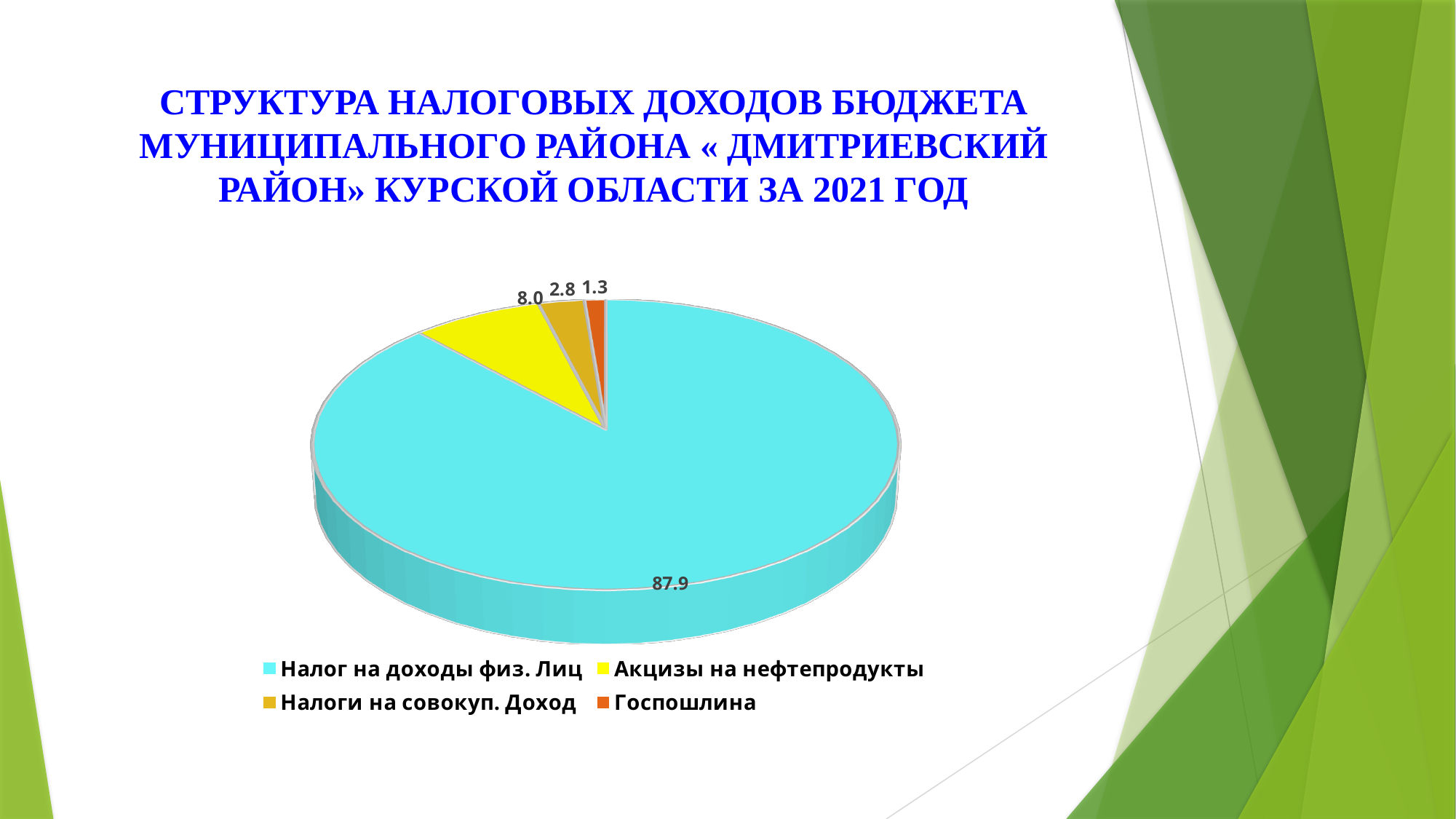
What value is shown for Налог на доходы физ. Лиц? 87.9 What is the difference between the values for Налог на доходы физ. Лиц and Акцизы на нефтепродукты? 79.9 What value is shown for Госпошлина? 1.3 What is the difference between the values for Налоги на совокуп. Доход and Госпошлина? 1.5 What colour is the slice for Акцизы на нефтепродукты? Yellow What value is shown for Акцизы на нефтепродукты? 8.0 Which category has the smallest slice of the pie? Госпошлина What kind of chart is shown on the slide? Pie chart How many slices does the pie chart have? 4 Which category has the largest slice of the pie? Налог на доходы физ. Лиц What value is shown for Налоги на совокуп. Доход? 2.8 Which is larger, the value for Акцизы на нефтепродукты or the value for Налоги на совокуп. Доход? Акцизы на нефтепродукты